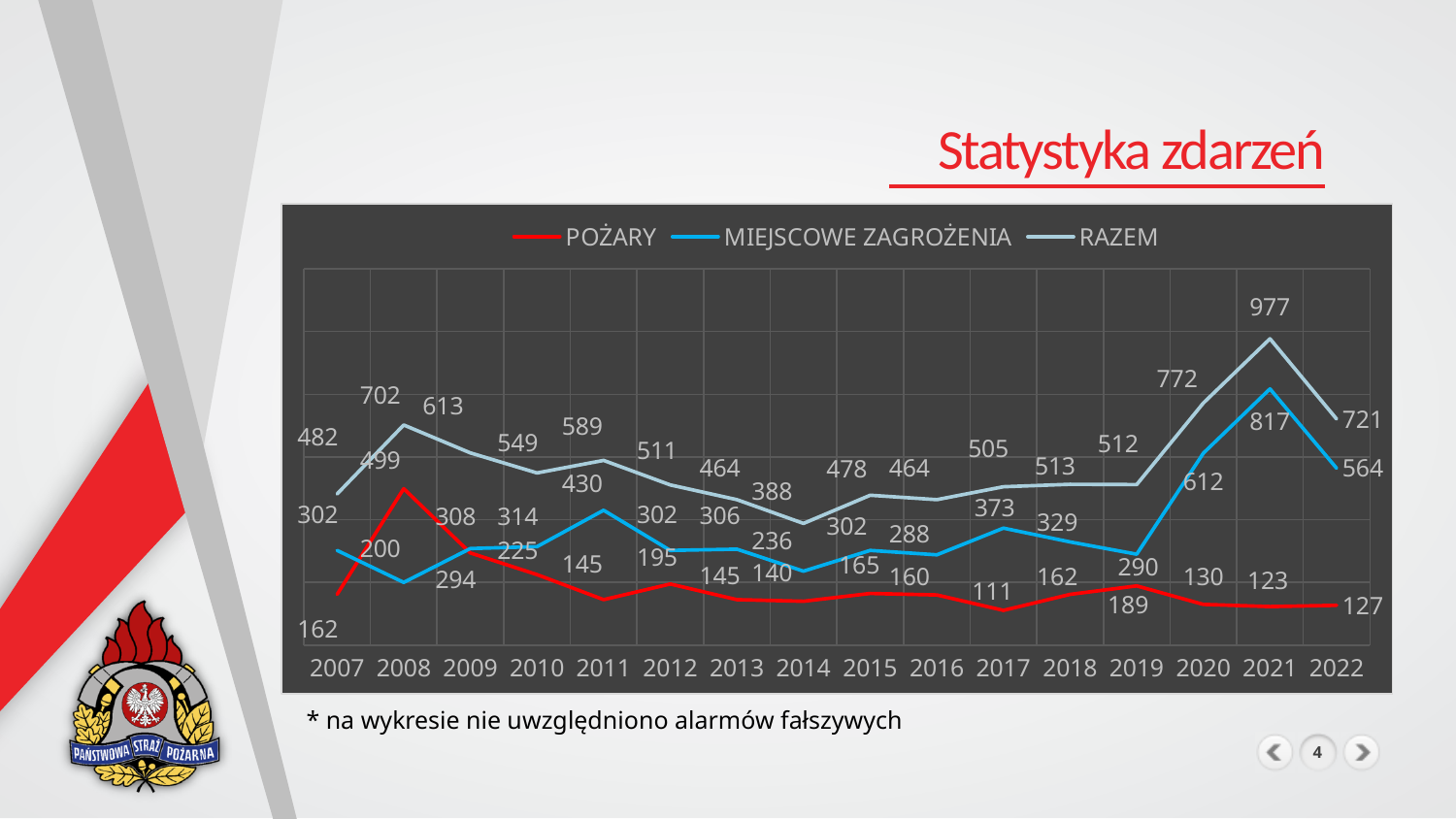
In which year is RAZEM the highest? 2021 What is the value of POŻARY in 2008? 499 What is the title of the slide above the chart? Statystyka zdarzeń What type of chart is shown on the slide? line chart What is the difference between RAZEM in 2021 and RAZEM in 2020? 205 How many years are shown on the x axis? 16 What is the value of MIEJSCOWE ZAGROŻENIA in 2020? 612 How many series does the legend list? 3 Does RAZEM rise or fall from 2021 to 2022? fall What is the value of RAZEM in 2021? 977 Which is larger: MIEJSCOWE ZAGROŻENIA in 2011 or MIEJSCOWE ZAGROŻENIA in 2012? 2011 In which year is POŻARY the lowest? 2017